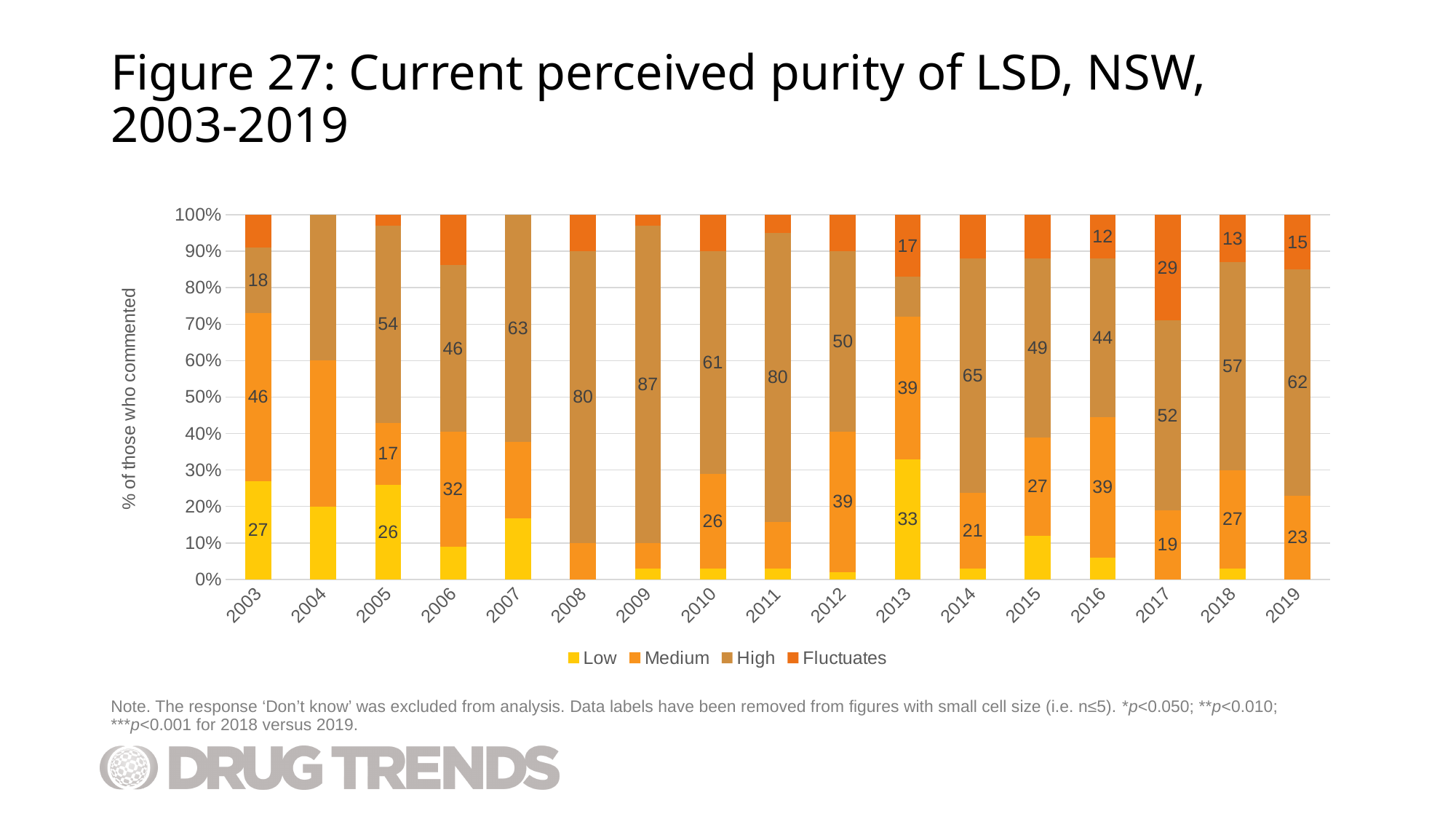
What is the value for Low in 2013? 33 Which year has the highest labelled value for High? 2009 How many years are shown on the x axis? 17 What is the difference between the High values for 2019 and 2018? 5 Which is larger, the Fluctuates value in 2017 or in 2019? 2017 Is the Low segment for 2004 greater or less than 10%? greater How many series does the legend list? 4 What is the value for Medium in 2003? 46 What is the value for Fluctuates in 2017? 29 What is the value for High in 2009? 87 What kind of chart is shown? Stacked bar chart What is the total of the labelled segments in the 2019 bar? 100